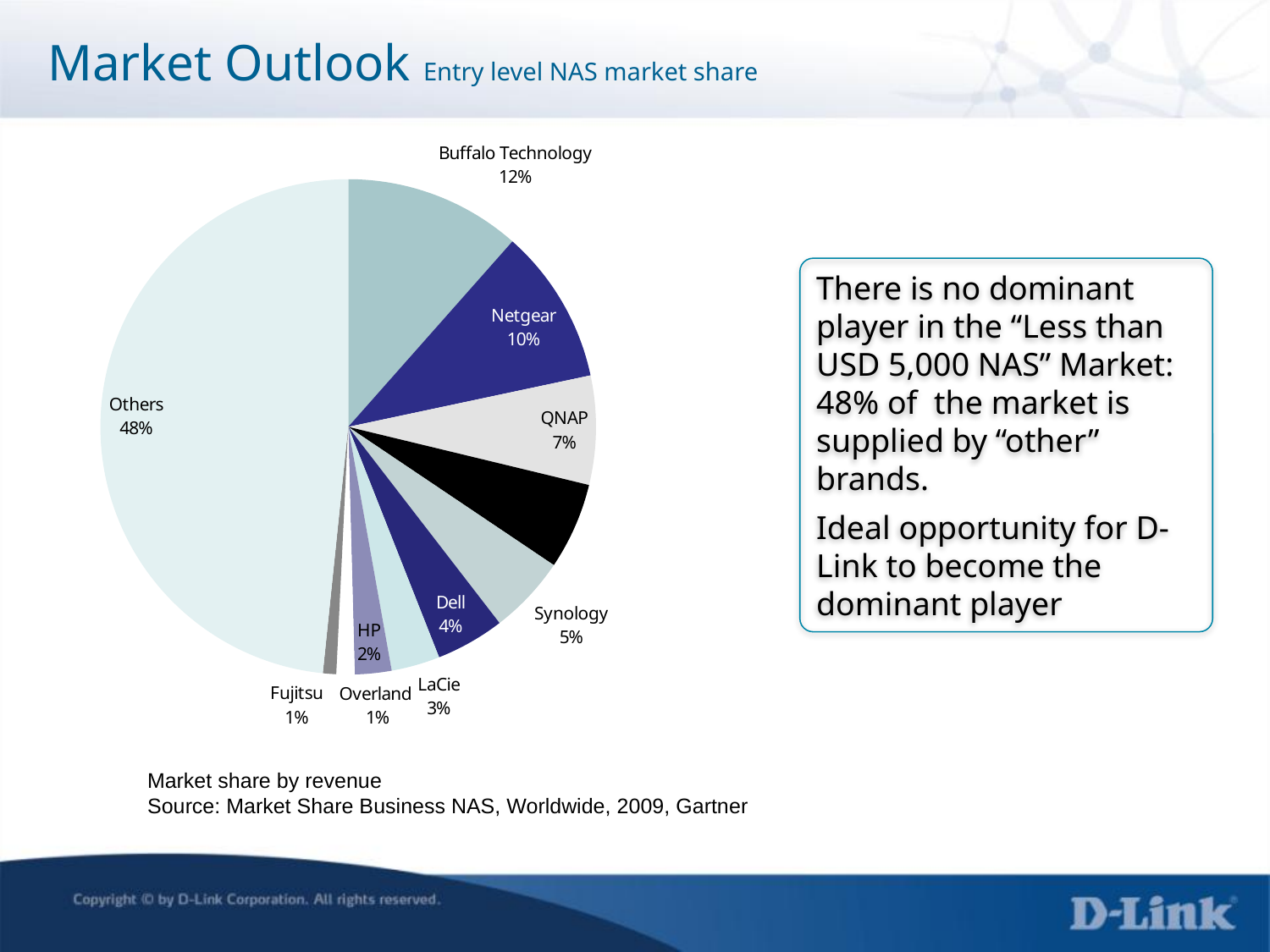
What is the market share of Netgear? 10% What kind of chart is shown on the slide? pie chart How much larger is the Others share than the Buffalo Technology share? 36% Which has the larger market share, HP or LaCie? LaCie What is the market share of Synology? 5% Which has the larger market share, Dell or Synology? Synology What market share does Buffalo Technology hold? 12% What share of the pie is taken by Others? 48% According to the slide, what is the source of the market share data? Market Share Business NAS, Worldwide, 2009, Gartner What share of the market does QNAP have? 7% Which slice of the pie is the largest? Others What is the difference between the market shares of Buffalo Technology and Netgear? 2%